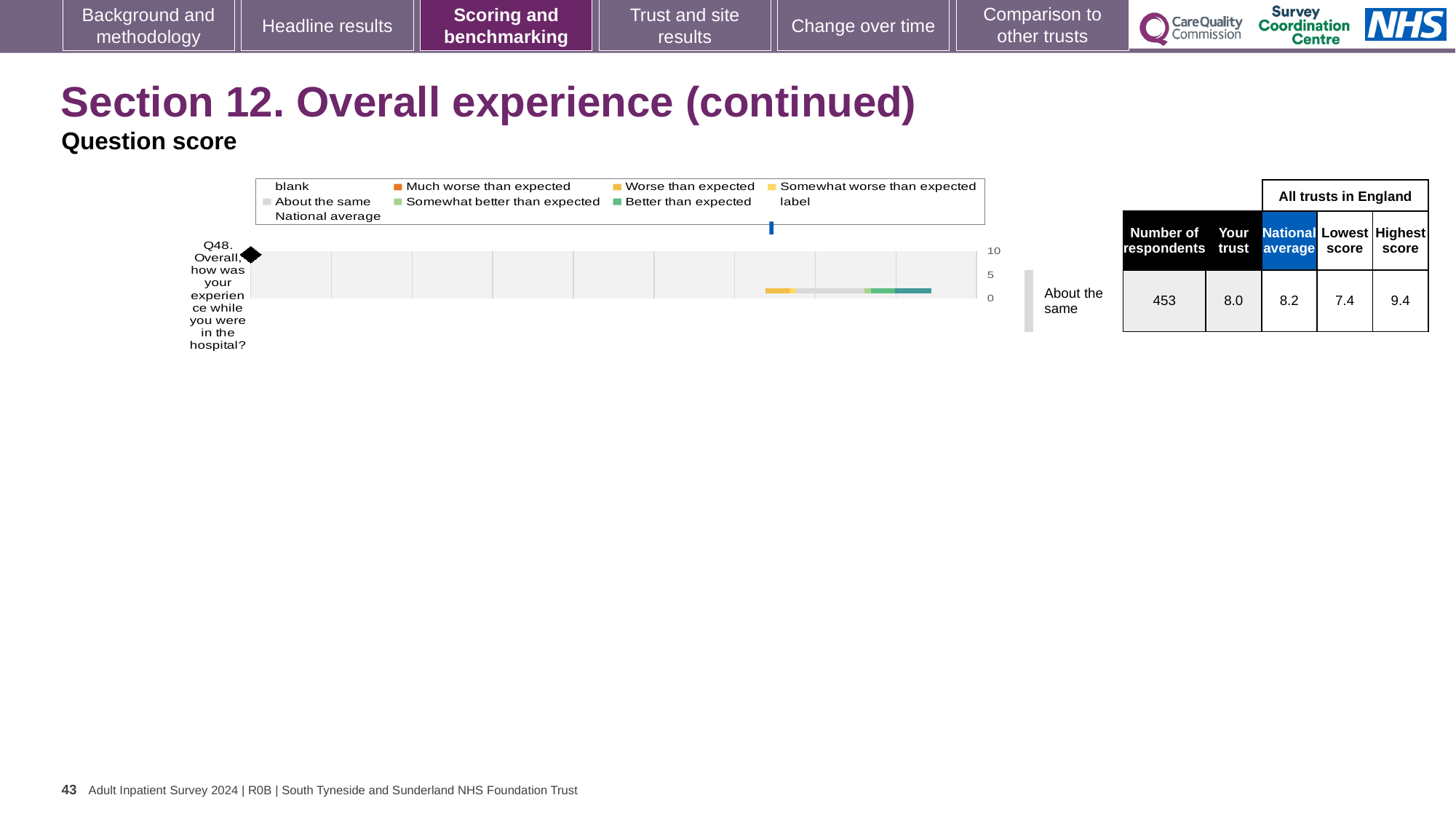
According to the table next to the chart, what is the 'Your trust' score for Q48? 8.0 Which question number is plotted on the chart? Q48 According to the table next to the chart, what is the lowest score among all trusts in England for Q48? 7.4 According to the table next to the chart, what is the difference between the highest score and the lowest score for Q48? 2.0 According to the table next to the chart, what is the highest score among all trusts in England for Q48? 9.4 According to the table next to the chart, what is the national average score for Q48? 8.2 What is the highest value shown on the chart's axis? 10 What kind of chart is shown on the slide? bar chart According to the table next to the chart, what is the number of respondents for Q48? 453 How many questions (categories) are plotted on the chart? 1 What benchmark category is the trust assigned for Q48, as shown beside the chart? About the same According to the table next to the chart, which is larger for Q48: the 'Your trust' score or the national average? National average